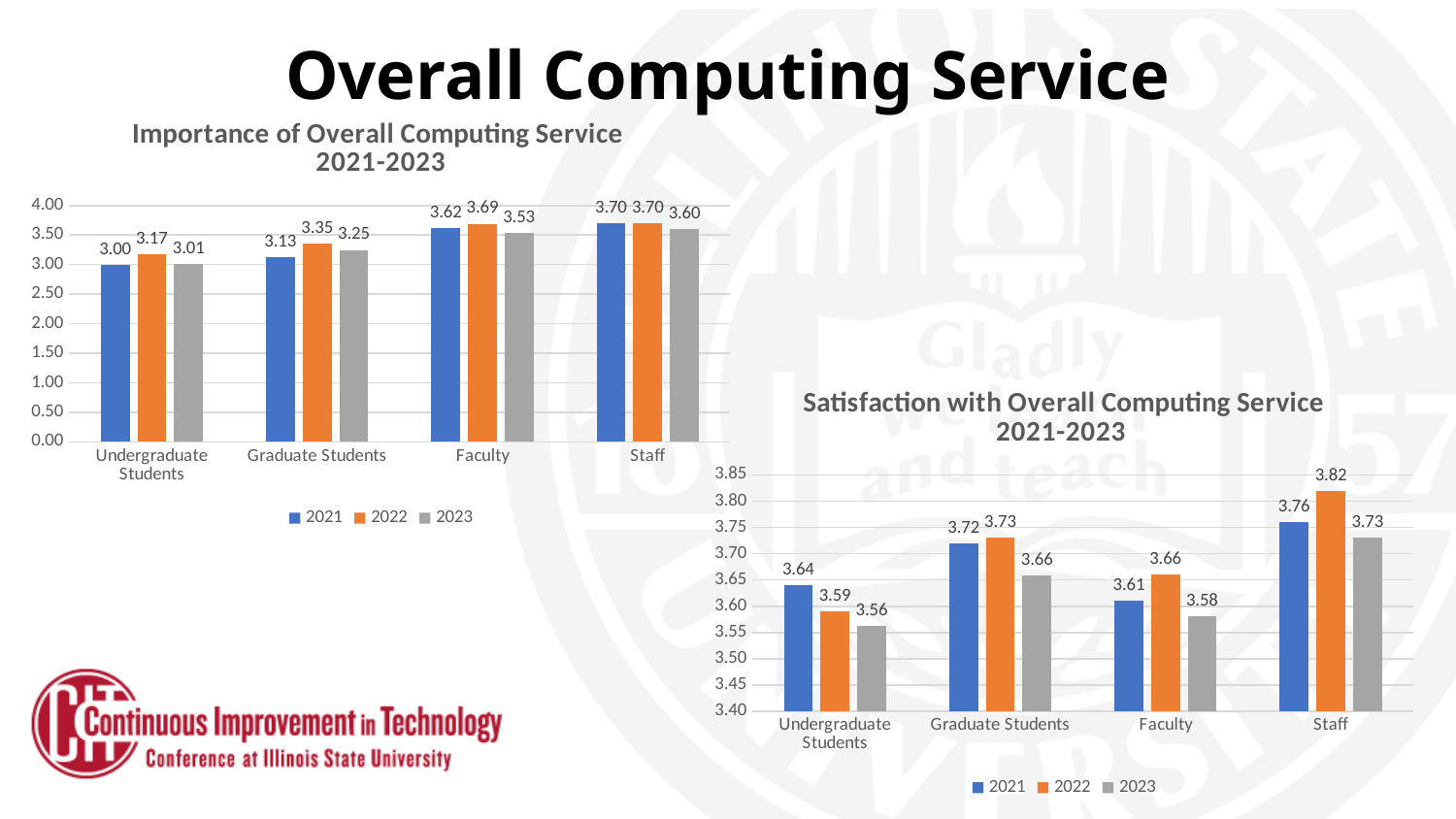
In the 'Satisfaction with Overall Computing Service 2021-2023' chart, which is larger for Undergraduate Students: the 2021 value or the 2023 value? 2021 In the 'Satisfaction with Overall Computing Service 2021-2023' chart, how many categories are shown on the x axis? 4 In the 'Satisfaction with Overall Computing Service 2021-2023' chart, do the Undergraduate Students values rise or fall from 2021 to 2023? fall In the 'Importance of Overall Computing Service 2021-2023' chart, what is the difference between the Faculty values for 2022 and 2023? 0.16 In the 'Importance of Overall Computing Service 2021-2023' chart, what is the value for Graduate Students in 2022? 3.35 In the 'Importance of Overall Computing Service 2021-2023' chart, how many series does the legend list? 3 In the 'Importance of Overall Computing Service 2021-2023' chart, is the 2023 value for Staff greater or less than 3.50? greater In the 'Satisfaction with Overall Computing Service 2021-2023' chart, which category has the highest value for 2023? Staff What kind of chart is the 'Importance of Overall Computing Service 2021-2023' chart? bar chart In the 'Satisfaction with Overall Computing Service 2021-2023' chart, what is the difference between the Staff values for 2022 and 2021? 0.06 In the 'Importance of Overall Computing Service 2021-2023' chart, which category has the lowest value for 2021? Undergraduate Students In the 'Satisfaction with Overall Computing Service 2021-2023' chart, what is the value for Staff in 2022? 3.82